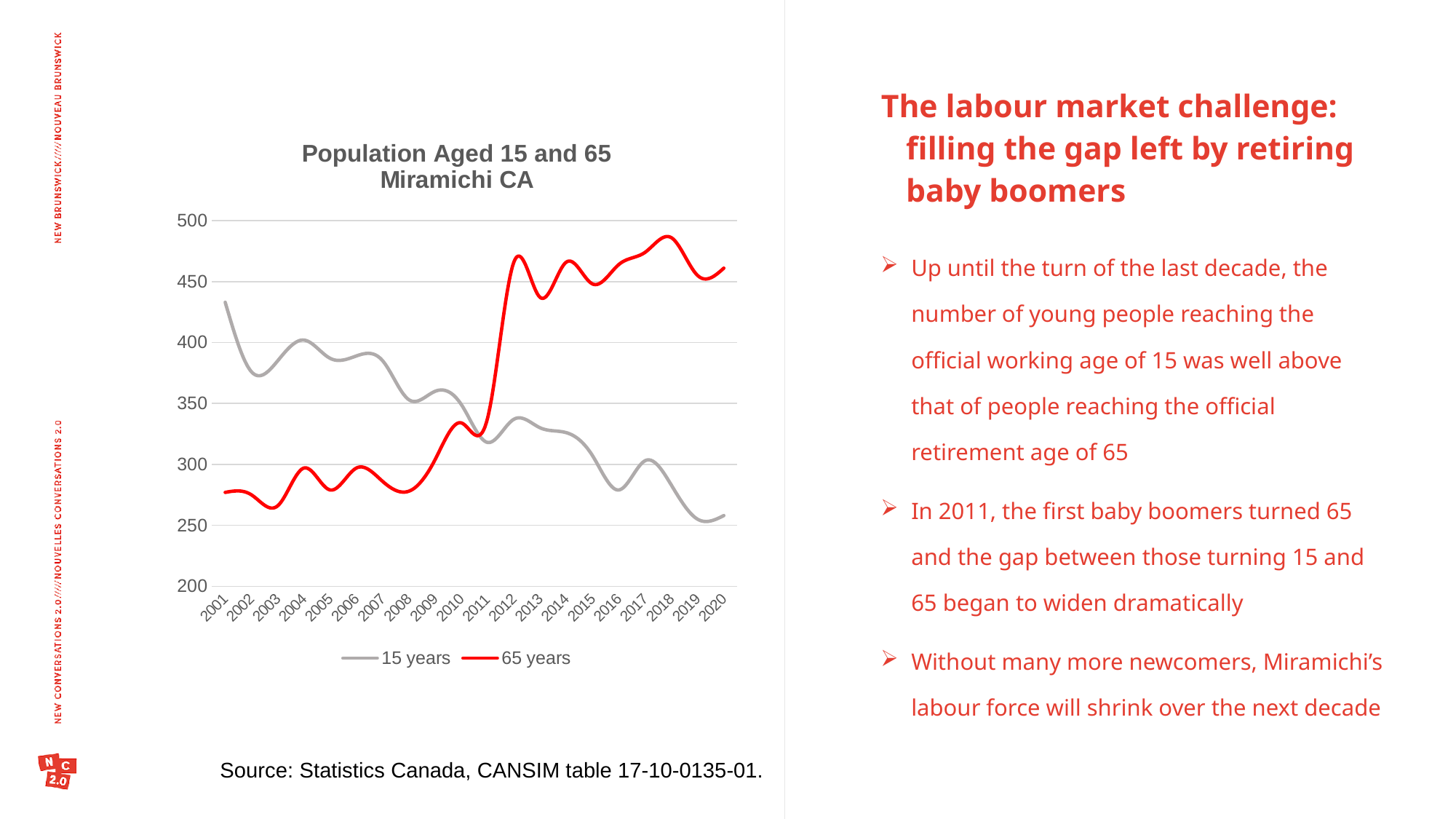
Is the value for 15 years in 2019 greater or less than 300? less Is the value for 15 years in 2001 greater or less than 400? greater How many years are shown on the x axis? 20 In 2020, which series has the higher value, 15 years or 65 years? 65 years Is the value for 65 years in 2003 greater or less than 300? less How many series does the legend list? 2 In which year is the 15 years series at its highest? 2001 In 2001, which series has the higher value, 15 years or 65 years? 15 years In which year is the 65 years series at its highest? 2018 What kind of chart is shown on the slide? Line chart Does the 15 years series overall rise or fall from 2001 to 2020? Fall